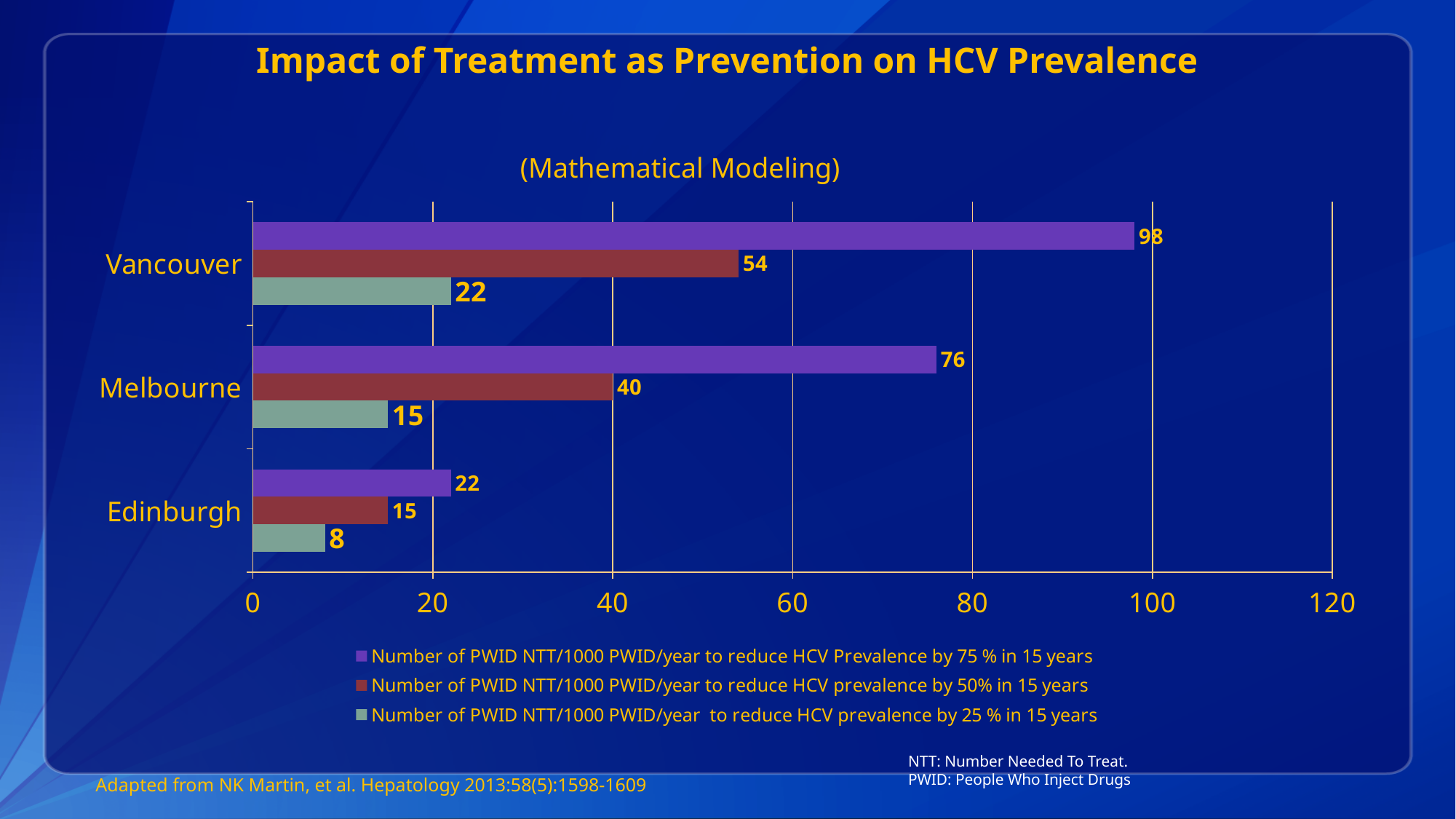
How many cities are shown on the chart? 3 Is the value for Melbourne to reduce HCV prevalence by 75% in 15 years greater or less than 60? greater Which is larger: Melbourne's value for reducing HCV prevalence by 50% or Vancouver's value for reducing HCV prevalence by 25%? Melbourne's value for reducing HCV prevalence by 50% How many series does the legend list? 3 What is the number of PWID NTT/1000 PWID/year to reduce HCV prevalence by 50% in 15 years for Melbourne? 40 Which city has the highest number of PWID NTT/1000 PWID/year to reduce HCV prevalence by 75% in 15 years? Vancouver What is the difference between Vancouver's and Melbourne's values for reducing HCV prevalence by 75% in 15 years? 22 What kind of chart is shown on the slide? Bar chart What is the number of PWID NTT/1000 PWID/year to reduce HCV prevalence by 75% in 15 years for Vancouver? 98 What is the number of PWID NTT/1000 PWID/year to reduce HCV prevalence by 25% in 15 years for Edinburgh? 8 Which city has the lowest number of PWID NTT/1000 PWID/year to reduce HCV prevalence by 25% in 15 years? Edinburgh What is the title of the chart? Impact of Treatment as Prevention on HCV Prevalence